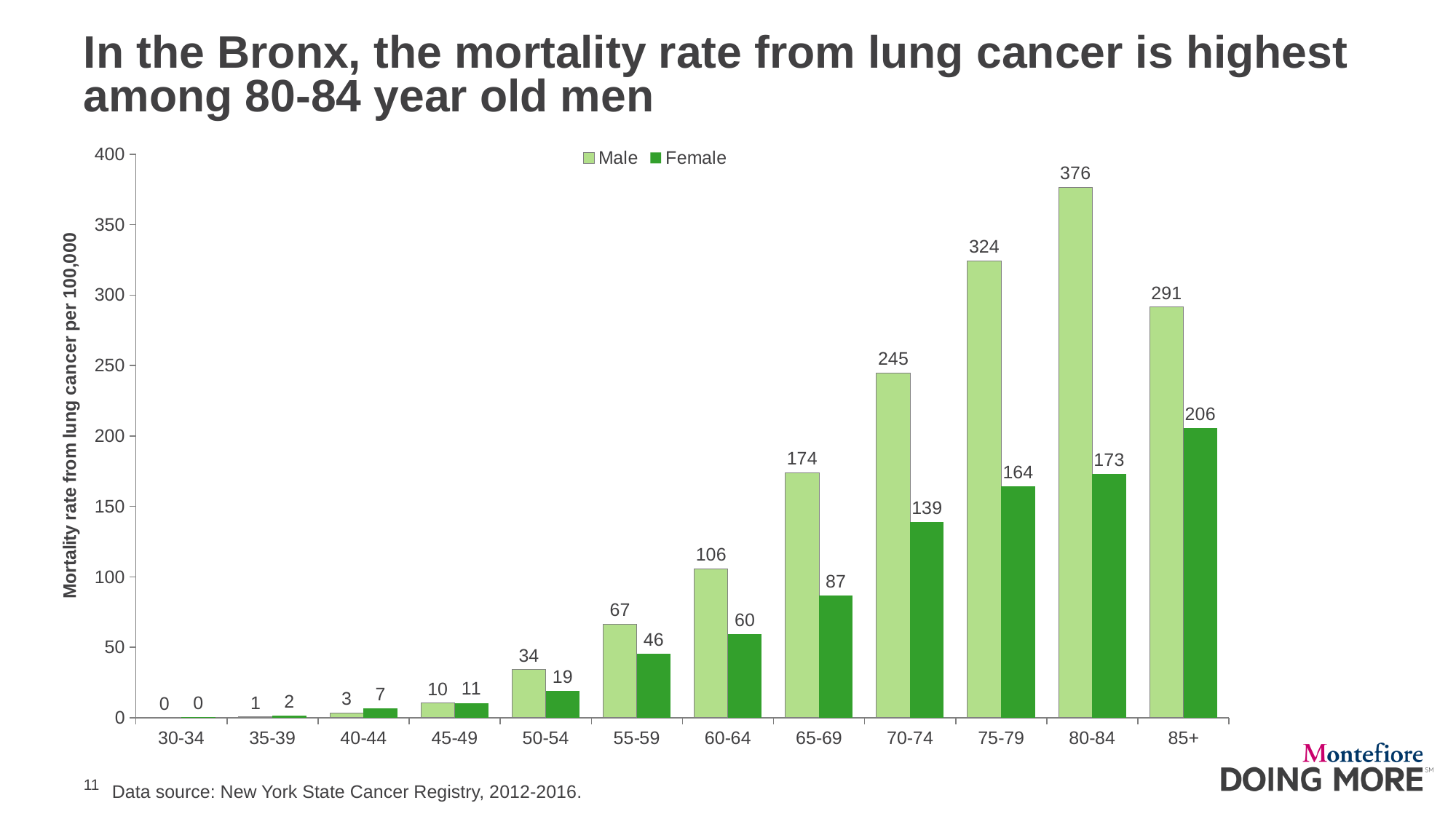
Which is larger in the 45-49 age group, the male or the female mortality rate? Female Which age group has the highest male mortality rate from lung cancer? 80-84 What is the female mortality rate from lung cancer for the 60-64 age group? 60 What is the label of the y axis? Mortality rate from lung cancer per 100,000 Which age group has the highest female mortality rate from lung cancer? 85+ What kind of chart is shown on the slide? Bar chart What is the female mortality rate from lung cancer for the 85+ age group? 206 What is the male mortality rate from lung cancer for the 80-84 age group? 376 Is the male mortality rate for the 70-74 age group greater or less than 200? greater How many series does the legend list? 2 What is the difference between the male and female mortality rates in the 75-79 age group? 160 How many age groups are shown on the x axis? 12